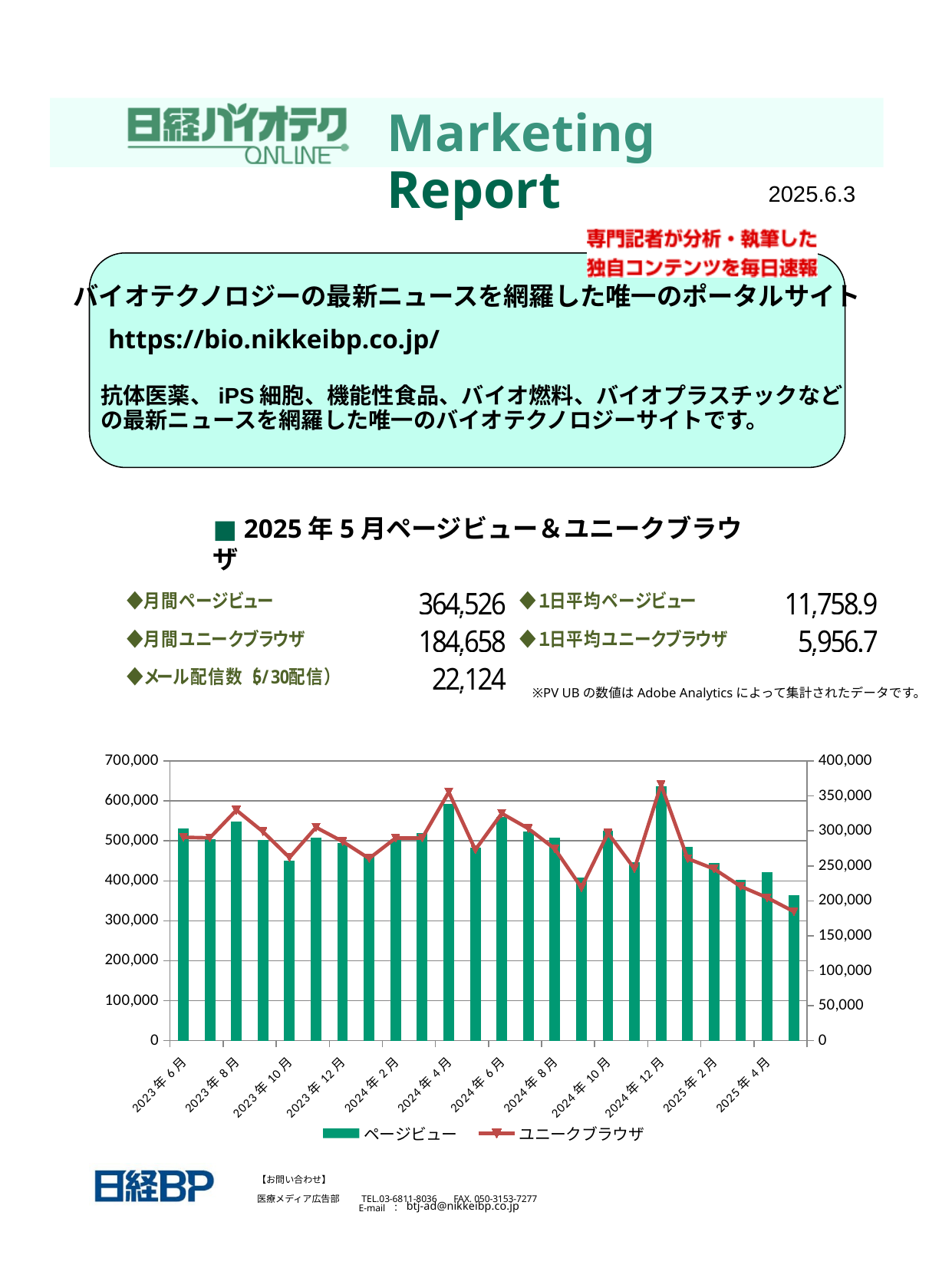
How many series does the chart legend list? 2 Is the ページビュー value for 2023年10月 greater or less than 500,000? less Which month has a higher ページビュー bar, 2024年4月 or 2024年8月? 2024年4月 Which series is drawn as a line in the chart? ユニークブラウザ Which month has the highest ページビュー bar in the chart? 2024年12月 How many monthly bars are plotted in the chart? 24 Do the ページビュー bars rise or fall from 2024年12月 to 2025年4月? fall What kind of chart is shown on the slide? A combined bar and line chart Is the ページビュー value for 2024年12月 greater or less than 600,000? greater Is the ページビュー value for 2025年4月 greater or less than 500,000? less Which series is drawn as bars in the chart? ページビュー